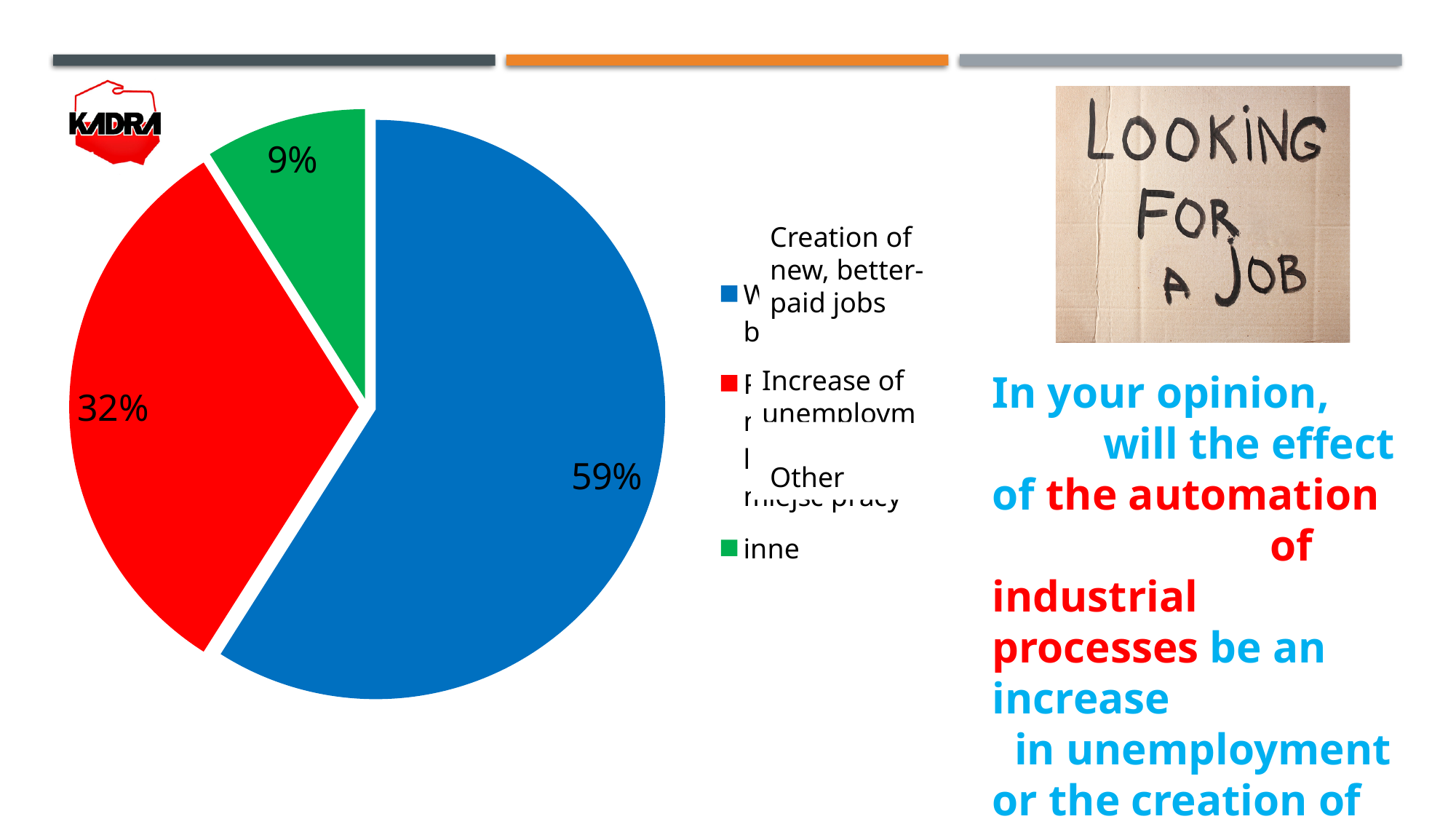
What share of the pie does the 'Other' slice represent? 9% What percentage is shown on the blue slice of the pie chart? 59% What colour is the slice labelled 'Other' in the pie chart? green What percentage is shown on the green slice of the pie chart? 9% What kind of chart is shown on the slide? pie chart Which slice of the pie chart is the smallest? Other (9%) What is the difference in percentage points between the blue slice and the red slice? 27 Which is larger, the red slice or the green slice? the red slice How many slices does the pie chart have? 3 What percentage is shown on the red slice of the pie chart? 32%